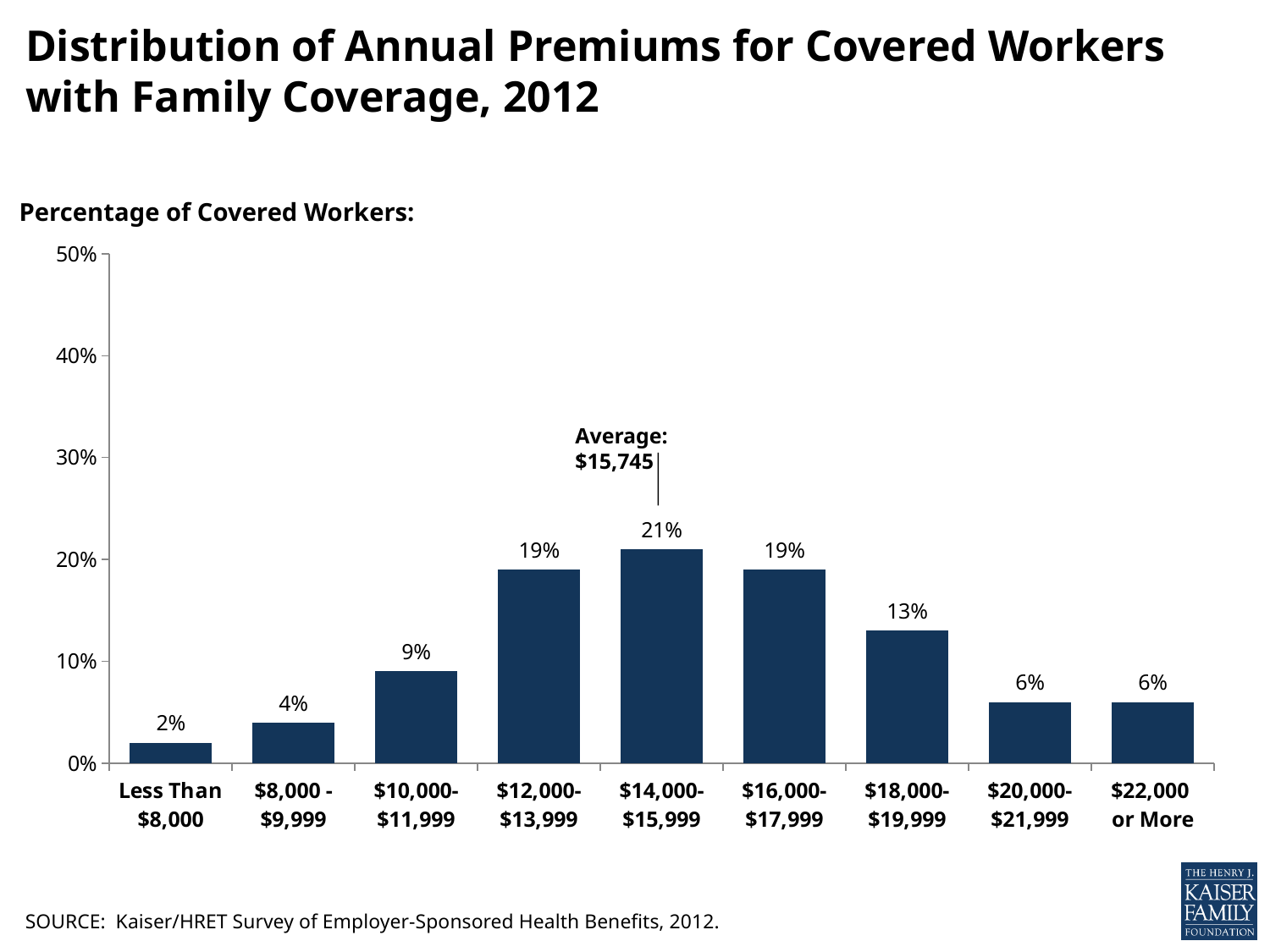
Is the value for the $12,000-$13,999 range greater or less than 10%? greater What percentage of covered workers have annual family premiums of less than $8,000? 2% How many premium ranges are shown on the x axis? 9 Which premium range has the lowest percentage of covered workers? Less Than $8,000 What percentage of covered workers have annual family premiums of $18,000-$19,999? 13% What kind of chart is shown on the slide? Bar chart Which has a larger percentage of covered workers: the $10,000-$11,999 range or the $20,000-$21,999 range? $10,000-$11,999 What is the average annual premium noted on the chart? $15,745 What is the combined percentage of covered workers in the $20,000-$21,999 and $22,000 or More ranges? 12% What percentage of covered workers have annual family premiums of $14,000-$15,999? 21% Which premium range has the highest percentage of covered workers? $14,000-$15,999 What is the difference in percentage points between the $14,000-$15,999 range and the $18,000-$19,999 range? 8